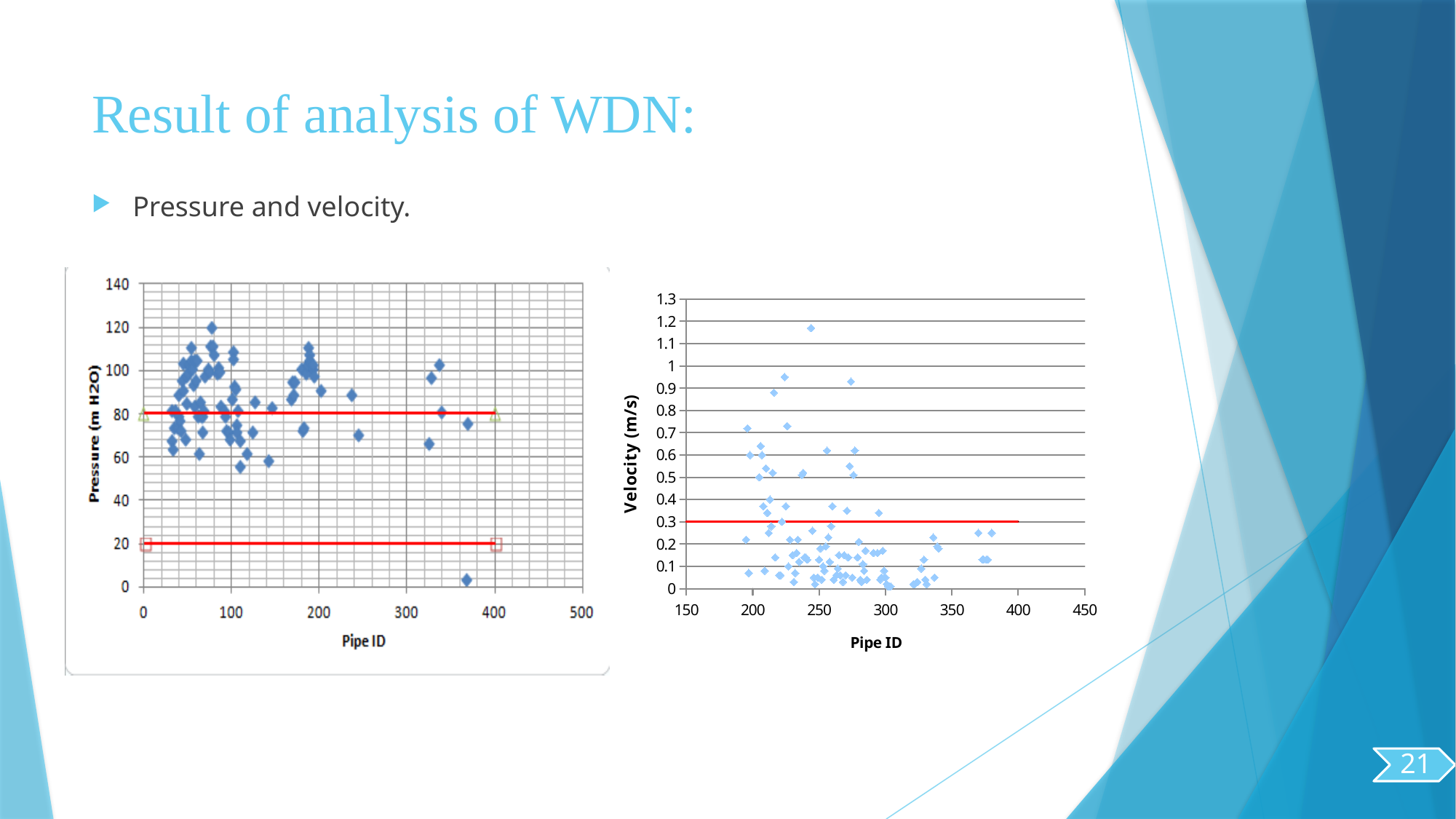
In the right chart, what is the maximum value shown on the vertical axis? 1.3 In the right chart, what is the label of the vertical axis? Velocity (m/s) In the right chart, is the highest plotted velocity value greater or less than 1? greater In the left chart, at what pressure value is the upper red horizontal line drawn? 80 In the left chart, at what pressure value is the lower red horizontal line drawn? 20 In the left chart, what is the label of the vertical axis? Pressure (m H2O) In the left chart, is the lowest plotted pressure value greater or less than 20? less In the right chart, at what velocity value is the red horizontal line drawn? 0.3 What kind of chart is the right chart showing Velocity against Pipe ID? Scatter chart In the right chart, is the velocity of the point at Pipe ID around 243 greater or less than 1.1? greater What kind of chart is the left chart showing Pressure against Pipe ID? Scatter chart